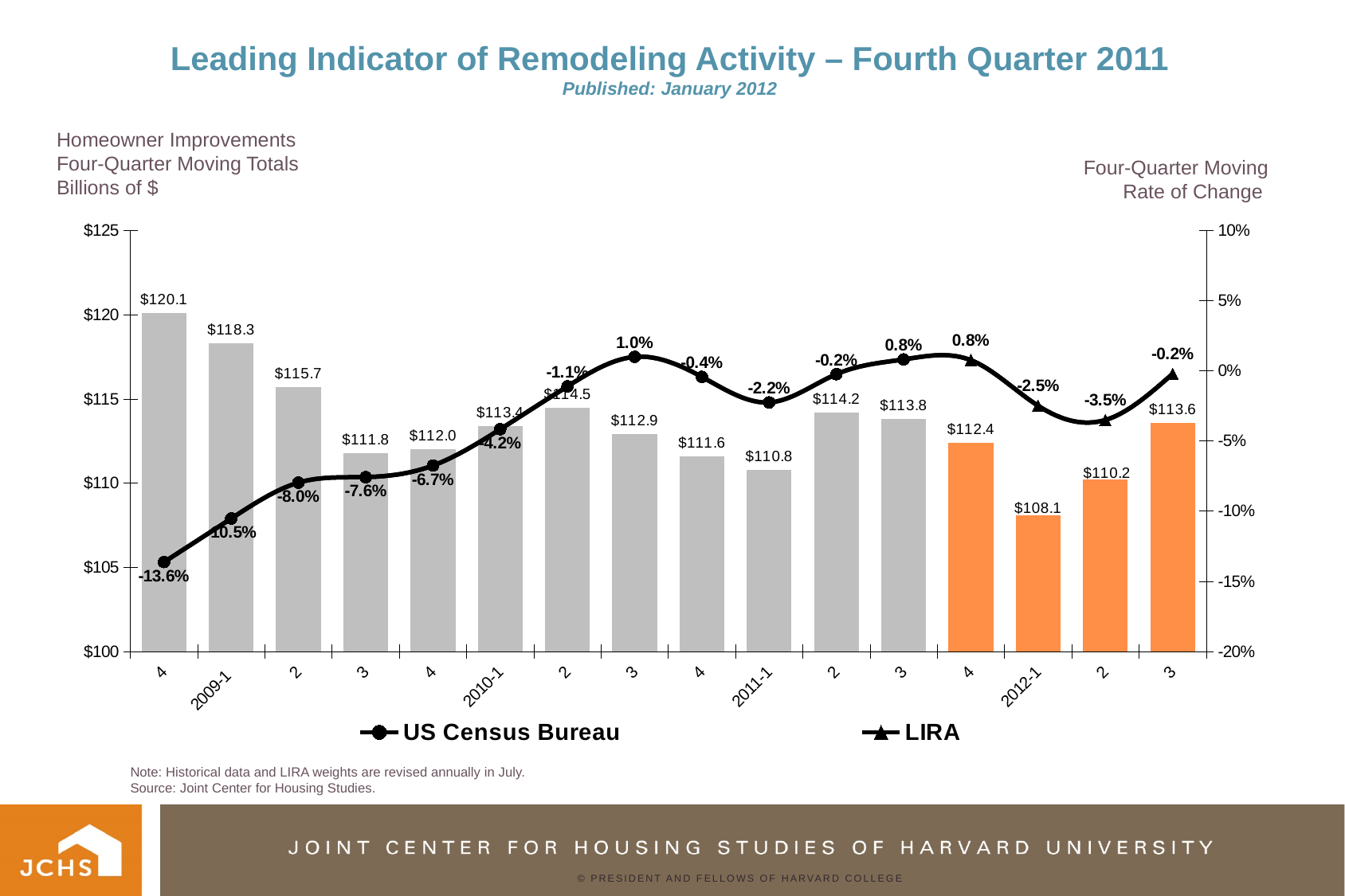
What is the four-quarter moving rate of change for 2010-3? 1.0% What is the difference between the four-quarter moving totals for 2011-2 and 2011-1? $3.4 What is the lowest four-quarter moving rate of change shown on the chart? -13.6% How many bars are coloured orange? 4 How many series does the legend list? 2 What is the LIRA rate of change shown for 2012-2? -3.5% What is the highest four-quarter moving total shown on the chart? $120.1 What is the four-quarter moving total for 2012-1? $108.1 How many bars are shown on the chart? 16 What is the four-quarter moving total for 2012-3? $113.6 Which quarter has the lowest four-quarter moving total? 2012-1 Which has the larger four-quarter moving total, 2010-2 or 2011-2? 2010-2